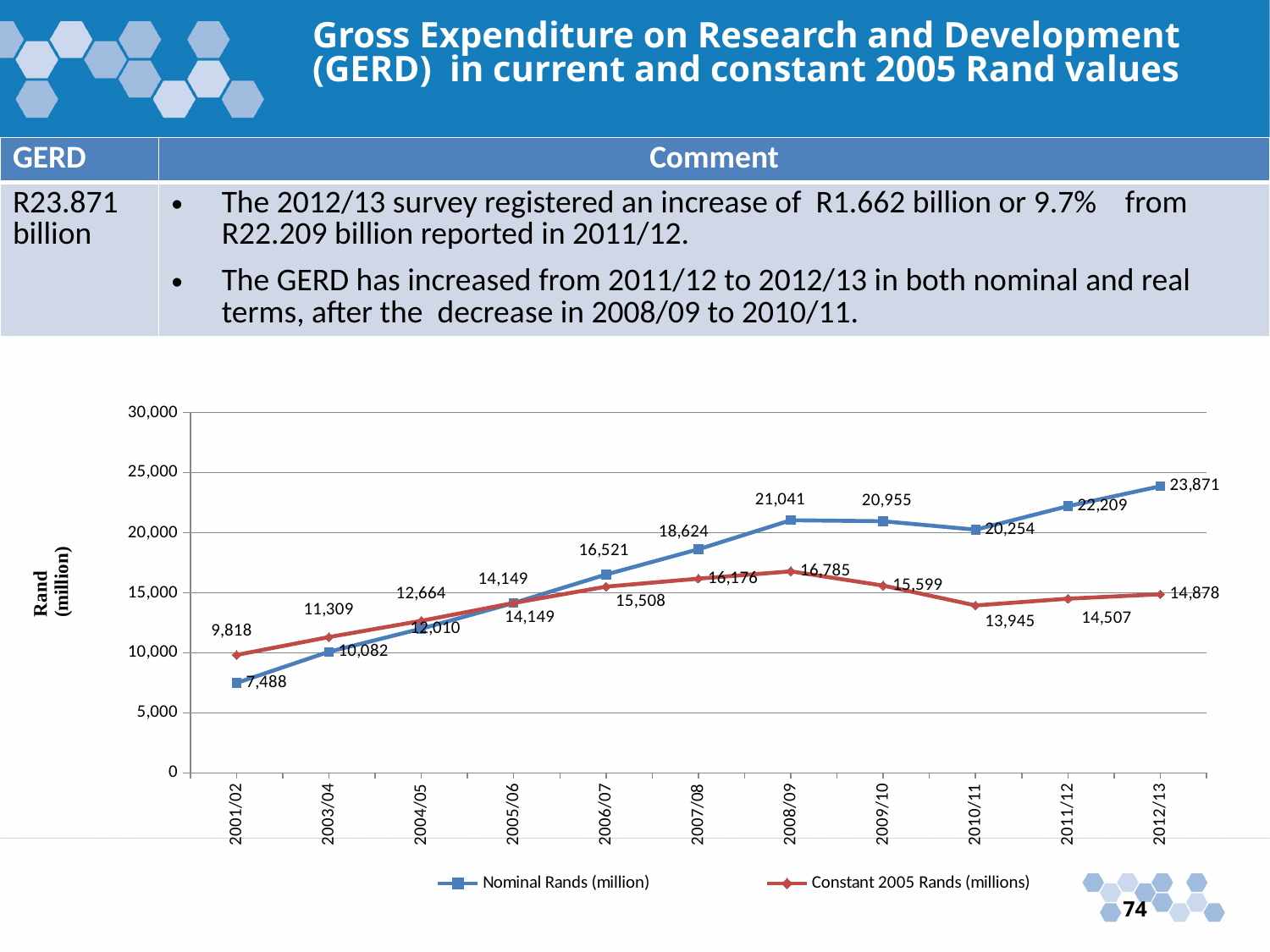
In which year is the Nominal Rands (million) series at its lowest? 2001/02 Which is larger in 2010/11: the Nominal Rands (million) value or the Constant 2005 Rands (millions) value? Nominal Rands (million) Does the Constant 2005 Rands (millions) series rise or fall from 2008/09 to 2010/11? fall What is the Nominal Rands (million) value for 2001/02? 7,488 In which year is the Constant 2005 Rands (millions) series at its highest? 2008/09 What is the y-axis label of the chart? Rand (million) What is the Constant 2005 Rands (millions) value for 2008/09? 16,785 How many series does the legend list? 2 What is the Nominal Rands (million) value for 2012/13? 23,871 What is the difference between the Nominal Rands (million) values for 2012/13 and 2011/12? 1,662 How many years are plotted along the x axis? 11 What type of chart is shown on the slide? line chart